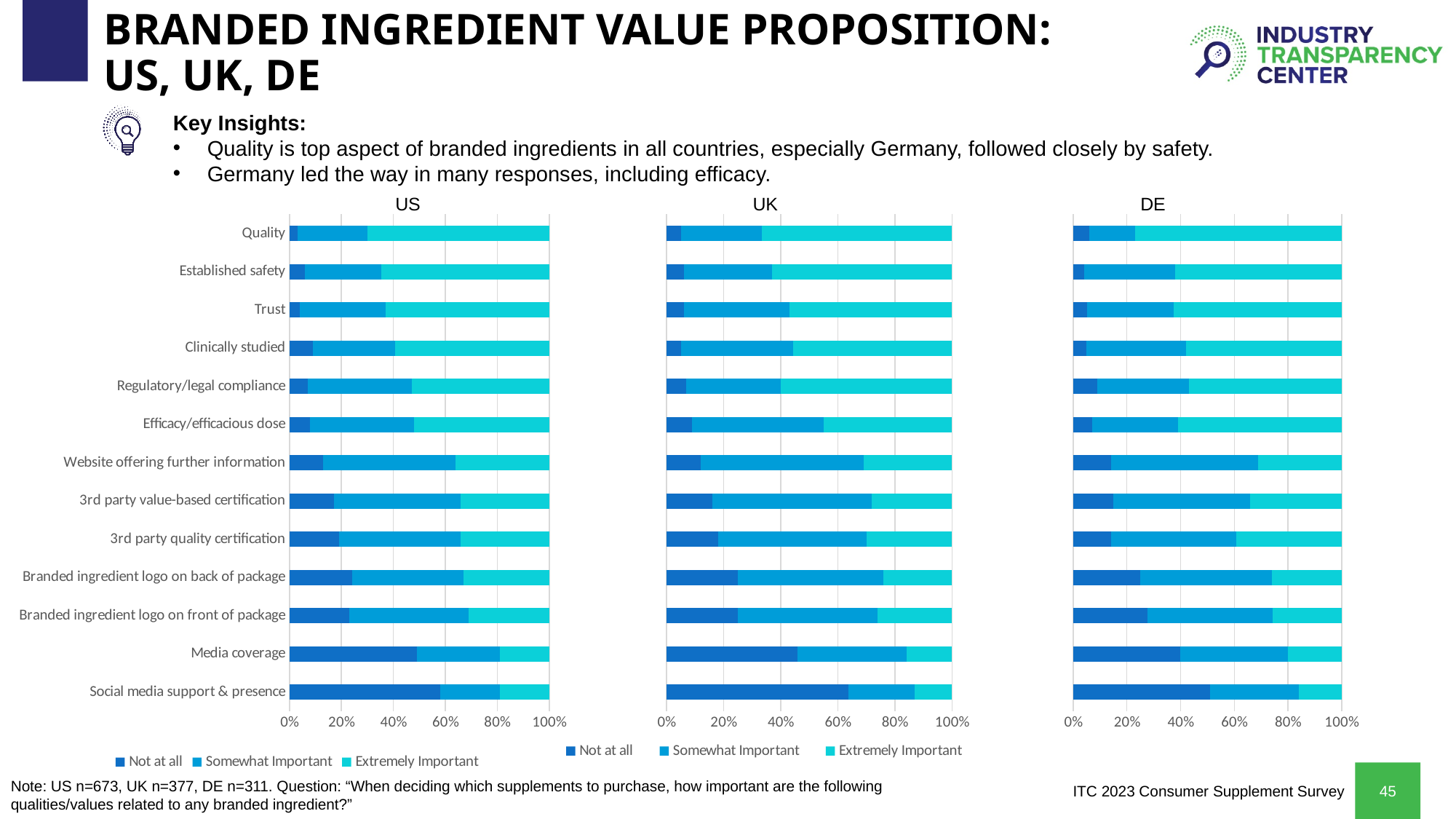
In the US chart, is the 'Not at all' share for Social media support & presence greater or less than 40%? greater How many categories are listed on the US chart? 13 What are the titles of the three charts on the slide? US, UK, DE In the DE chart, is the 'Not at all' share for Quality greater or less than 20%? less In the US chart, which category has the largest 'Not at all' share? Social media support & presence What kind of chart is the US chart? stacked bar chart How many series does the legend under the UK chart list? 3 In the DE chart, which has the larger 'Extremely Important' share: Quality or Media coverage? Quality In the UK chart, which category has the largest 'Extremely Important' share? Quality What are the three series named in the legend under the US chart? Not at all, Somewhat Important, Extremely Important In the UK chart, is the 'Not at all' share for Media coverage greater or less than 20%? greater